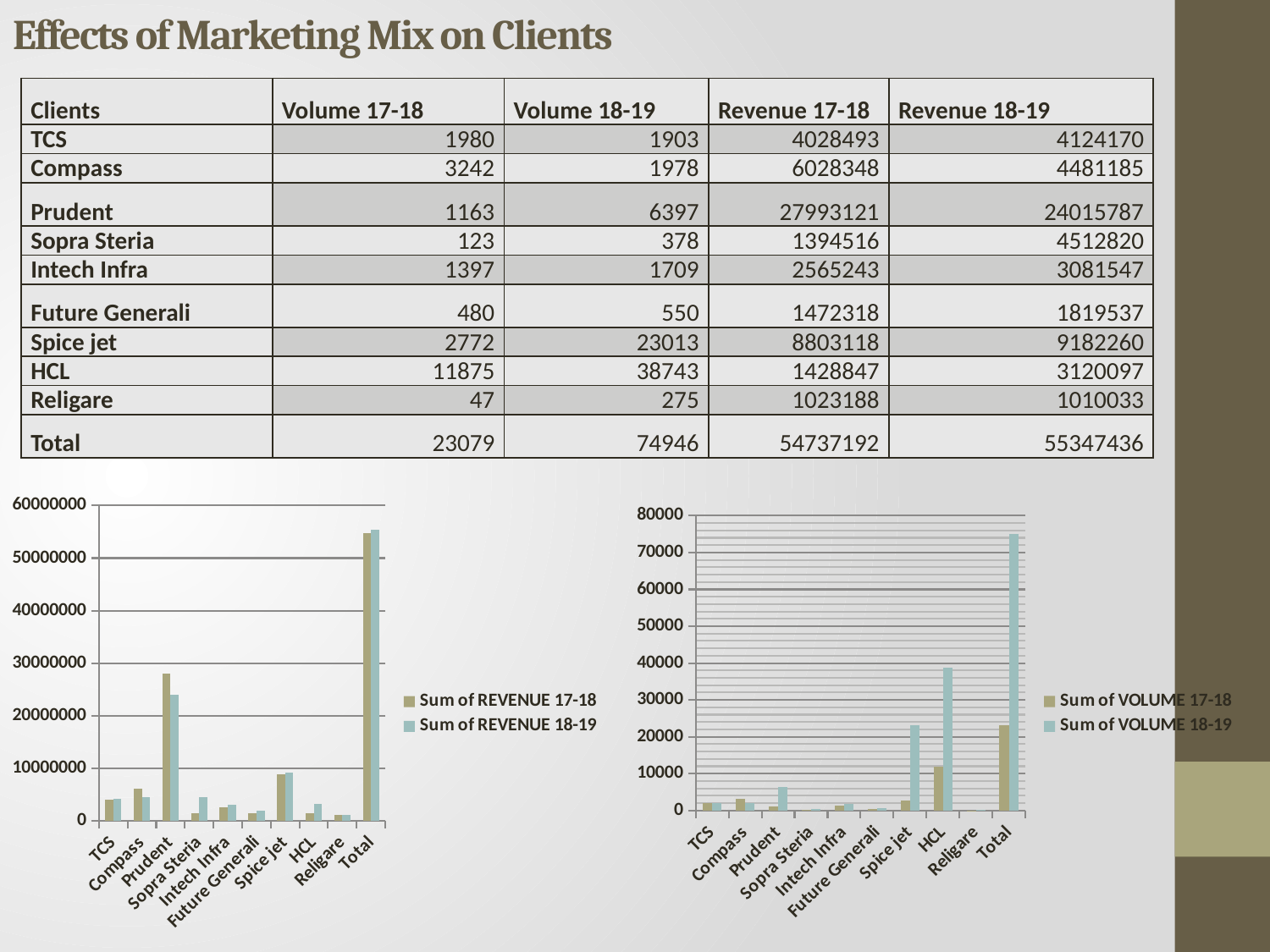
In the left chart, is the Sum of REVENUE 17-18 value for Prudent greater or less than 20000000? greater In the right chart, which is larger for Sum of VOLUME 18-19: Spice jet or HCL? HCL In the left chart, which Compass bar is taller: Sum of REVENUE 17-18 or Sum of REVENUE 18-19? Sum of REVENUE 17-18 In the right chart, which client (excluding Total) has the tallest Sum of VOLUME 18-19 bar? HCL In the left chart, which client (excluding Total) has the tallest Sum of REVENUE 17-18 bar? Prudent How many categories are shown along the x axis of the left chart? 10 What are the two legend entries of the left chart? Sum of REVENUE 17-18 and Sum of REVENUE 18-19 How many series does the legend of the right chart list? 2 In the right chart, is the Sum of VOLUME 18-19 value for Total greater or less than 70000? greater What kind of chart is the left chart on the slide? bar chart In the right chart, is the Sum of VOLUME 18-19 value for HCL greater or less than 30000? greater In the right chart, what is the difference between the Volume 18-19 values for HCL and Spice jet, as given in the table? 15730